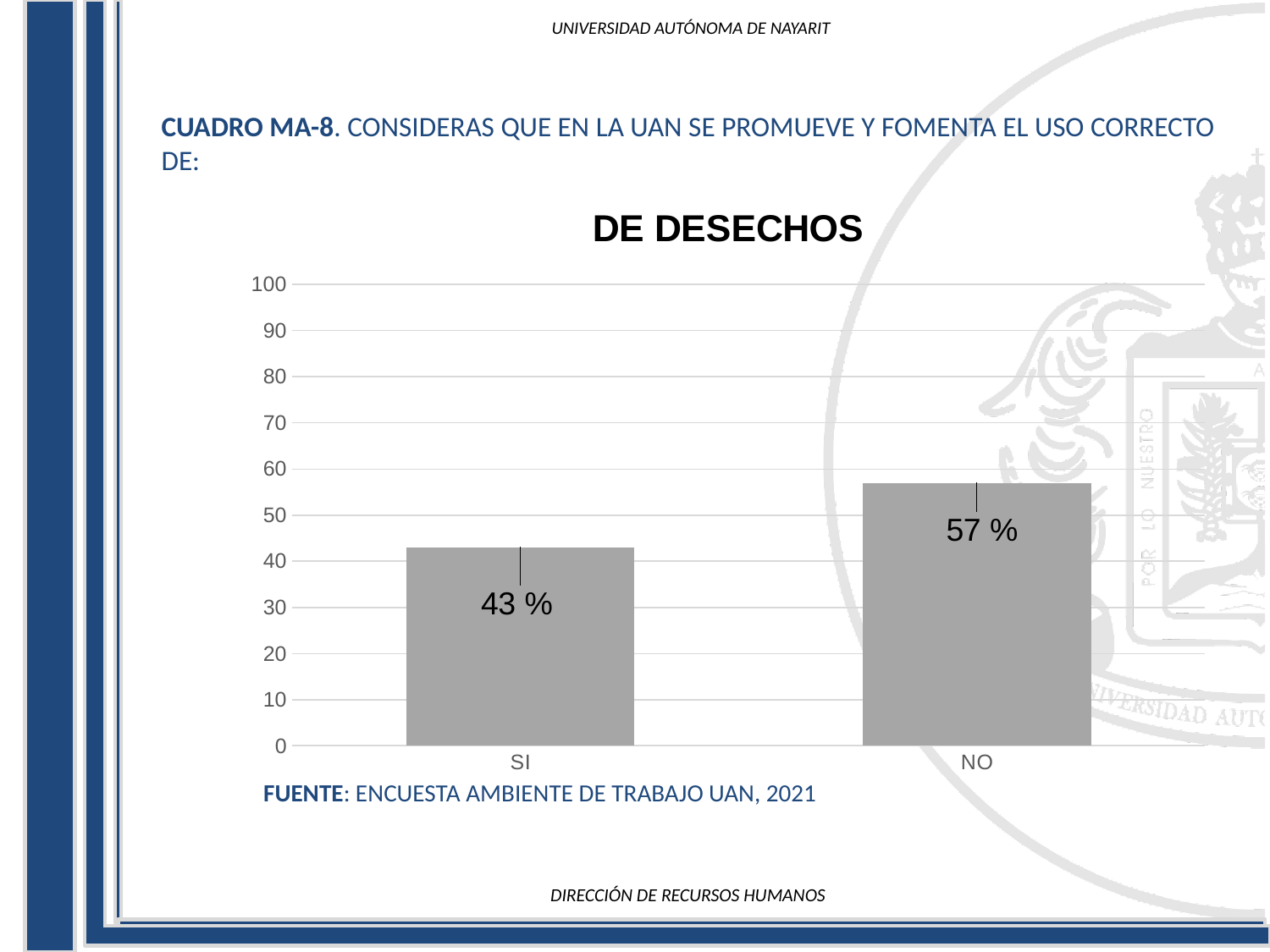
What is the maximum value shown on the y axis? 100 What is the value for SI? 43 % What is the title of the chart? DE DESECHOS What is the difference between the values for NO and SI? 14 % What kind of chart is shown on the slide? bar chart How many categories are shown on the x axis? 2 Is the value for SI greater or less than 50? less Which category has the lowest value? SI Which is larger, the value for SI or the value for NO? NO Which category has the highest value? NO What is the value for NO? 57 % Is the value for NO greater or less than 50? greater